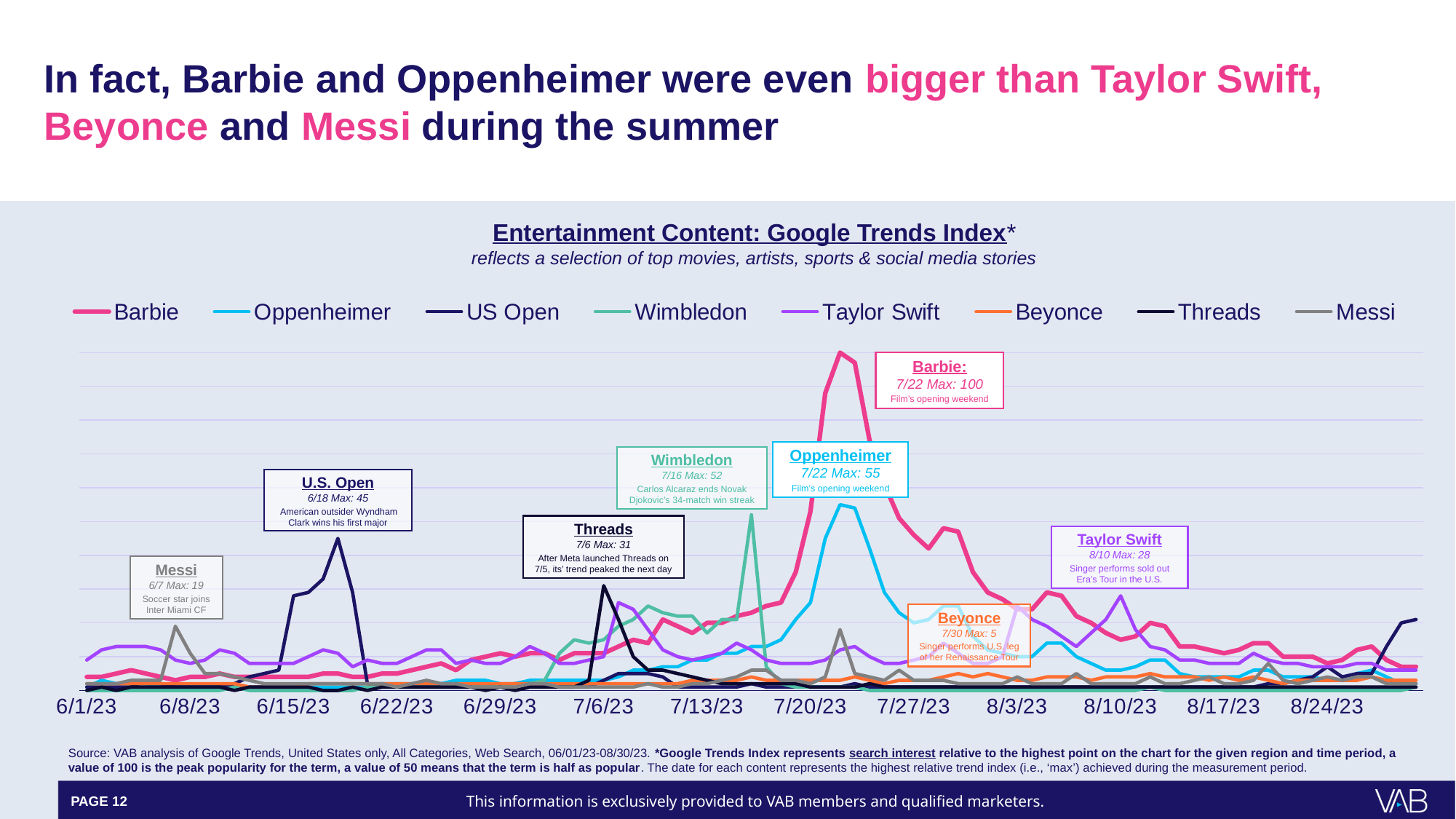
What is the title of the chart? Entertainment Content: Google Trends Index* What is the difference between the annotated maximum values of Messi and Beyonce? 14 Which series reaches the highest peak on the chart? Barbie On what date did Oppenheimer reach its maximum index value? 7/22 What is the maximum index value for Wimbledon shown in the annotation? 52 What is the difference between the annotated maximum values of Barbie and Oppenheimer? 45 What is the maximum index value for Taylor Swift shown in the annotation? 28 What is the maximum Google Trends Index value reached by Barbie, according to the annotation? 100 How many series does the legend list? 8 What type of chart is shown on the slide? Line chart Which has a higher annotated maximum value, U.S. Open or Threads? U.S. Open Which series has the lowest annotated maximum value? Beyonce